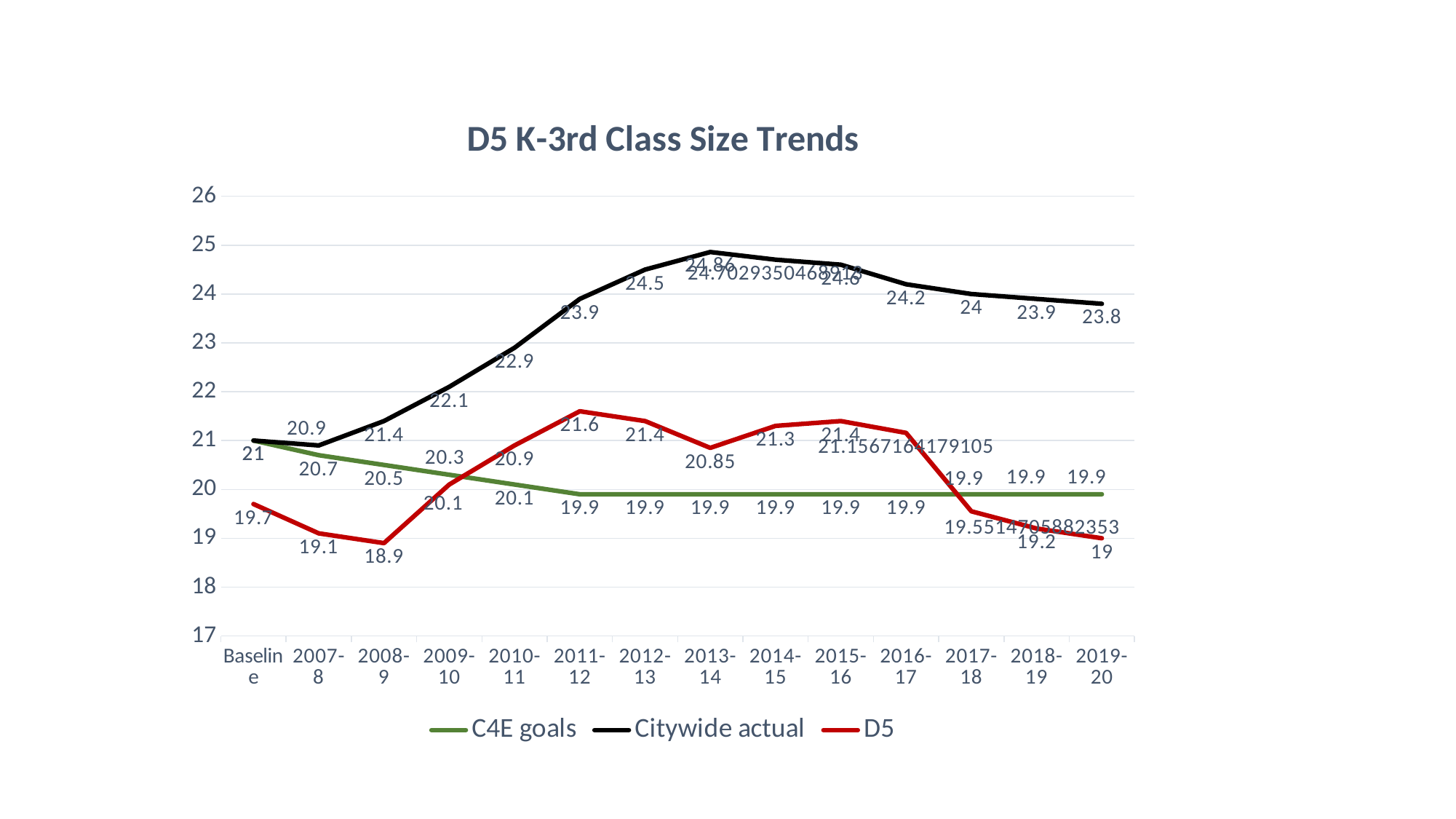
How many categories are shown on the x axis? 14 What kind of chart is shown on the slide? line chart What is the C4E goals value for 2009-10? 20.3 Is the D5 value for 2007-8 greater or less than 20? less What is the difference between the Citywide actual and D5 values for 2019-20? 4.8 For 2011-12, which is larger: the D5 value or the C4E goals value? D5 How many series does the legend list? 3 In which year is the D5 value lowest? 2008-9 In which year is the Citywide actual value highest? 2013-14 What is the Citywide actual value for 2012-13? 24.5 What is the D5 value for 2008-9? 18.9 Do the C4E goals values rise or fall from Baseline to 2011-12? fall